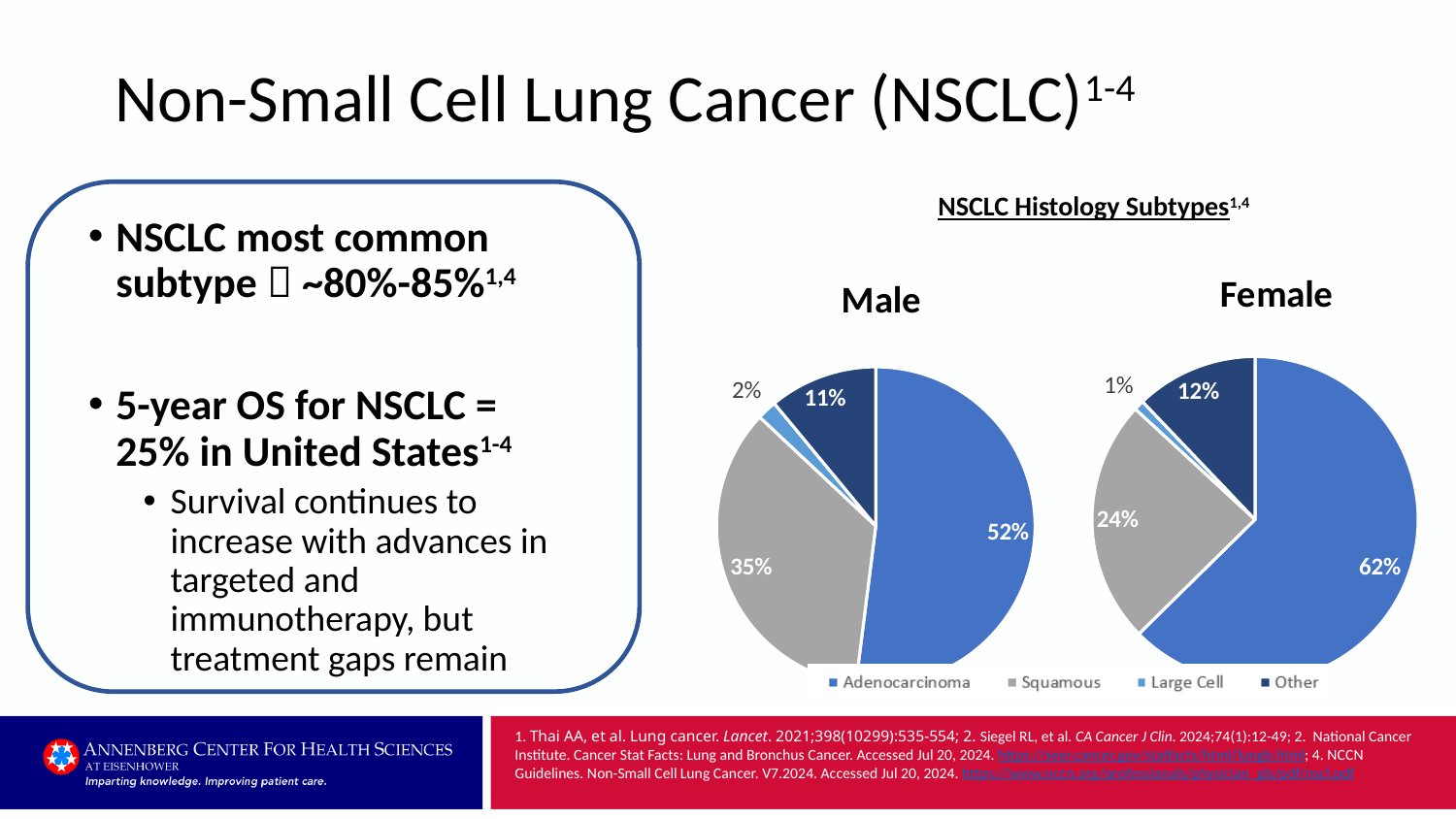
What is the difference between the Adenocarcinoma share in the Female pie chart and the Adenocarcinoma share in the Male pie chart? 10% What is the title shown above the two pie charts? NSCLC Histology Subtypes In the Male pie chart, which subtype has the smallest share? Large Cell In the Male pie chart, what percentage is Adenocarcinoma? 52% Is the Squamous share larger in the Male pie chart or the Female pie chart? Male In the Female pie chart, what percentage is Squamous? 24% In the Female pie chart, what percentage is Other? 12% What type of chart is used to show the NSCLC Histology Subtypes for Male and Female? Pie chart In the Male pie chart, what percentage is Large Cell? 2% In the Female pie chart, which subtype has the largest share? Adenocarcinoma How many histology subtypes does the legend list for the pie charts? 4 In the Male pie chart, what is the difference between the Squamous share and the Other share? 24%